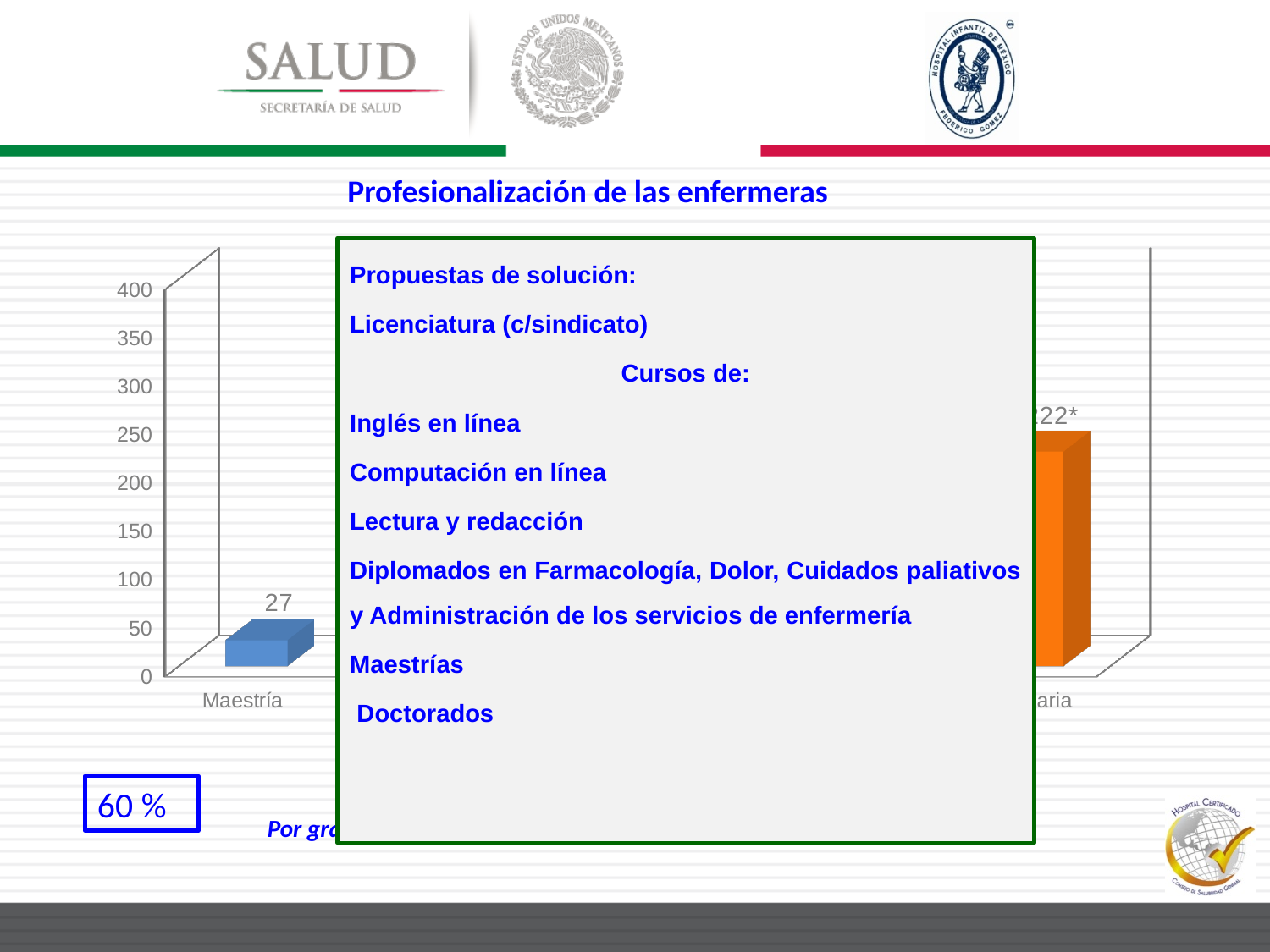
What kind of chart is shown on the slide? bar chart Which is larger: the blue Maestría bar or the orange bar on the right of the chart? the orange bar Is the value of the orange bar on the right of the chart greater or less than 200? greater What is the value shown for Maestría? 27 Is the value for Maestría greater or less than 50? less What is the highest value shown on the chart's vertical axis? 400 What colour is the bar for Maestría? blue